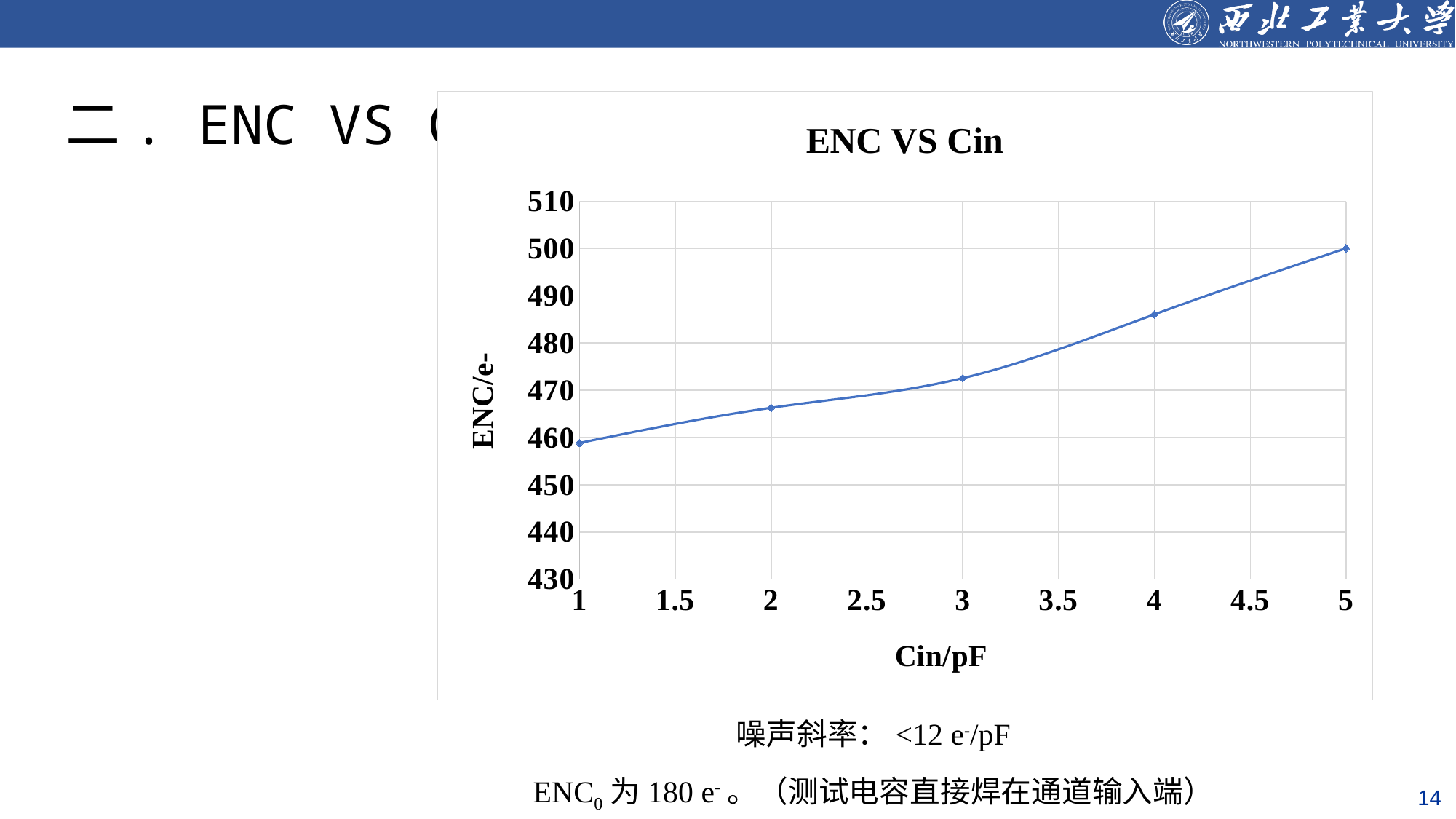
Is the ENC value at Cin = 1 pF greater or less than 450? greater Does ENC rise or fall as Cin increases from 1 to 5 pF? rise Which has the larger ENC value: Cin = 2 pF or Cin = 4 pF? Cin = 4 pF What is the label of the x axis of the chart? Cin/pF What is the title of the chart? ENC VS Cin Is the ENC value at Cin = 4 pF greater or less than 480? greater Is the ENC value at Cin = 3 pF greater or less than 480? less What kind of chart is shown on the slide? line chart At which Cin value is ENC highest? 5 At which Cin value is ENC lowest? 1 How many data points are plotted on the chart? 5